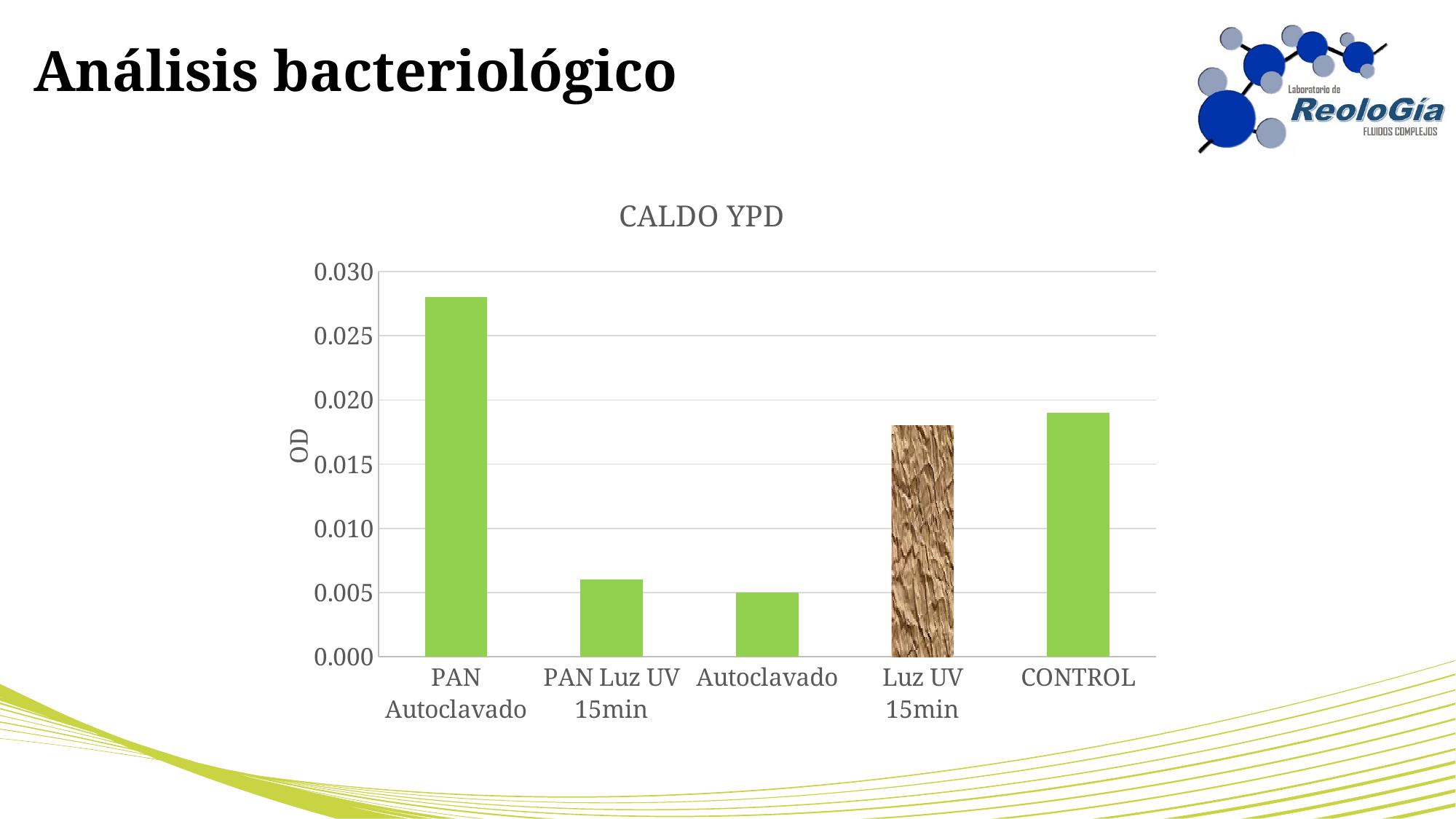
Which has a larger OD value, PAN Autoclavado or CONTROL? PAN Autoclavado Is the value for Luz UV 15min greater or less than 0.020? less What is the title of the chart? CALDO YPD Which category has the highest OD value? PAN Autoclavado What is the OD value for Autoclavado? 0.005 Which category has the lowest OD value? Autoclavado Is the value for PAN Autoclavado greater or less than 0.025? greater How many categories are plotted in the chart? 5 What type of chart is shown on the slide? bar chart Which has a larger OD value, CONTROL or Autoclavado? CONTROL Is the value for PAN Luz UV 15min greater or less than 0.010? less What is the label of the vertical axis? OD